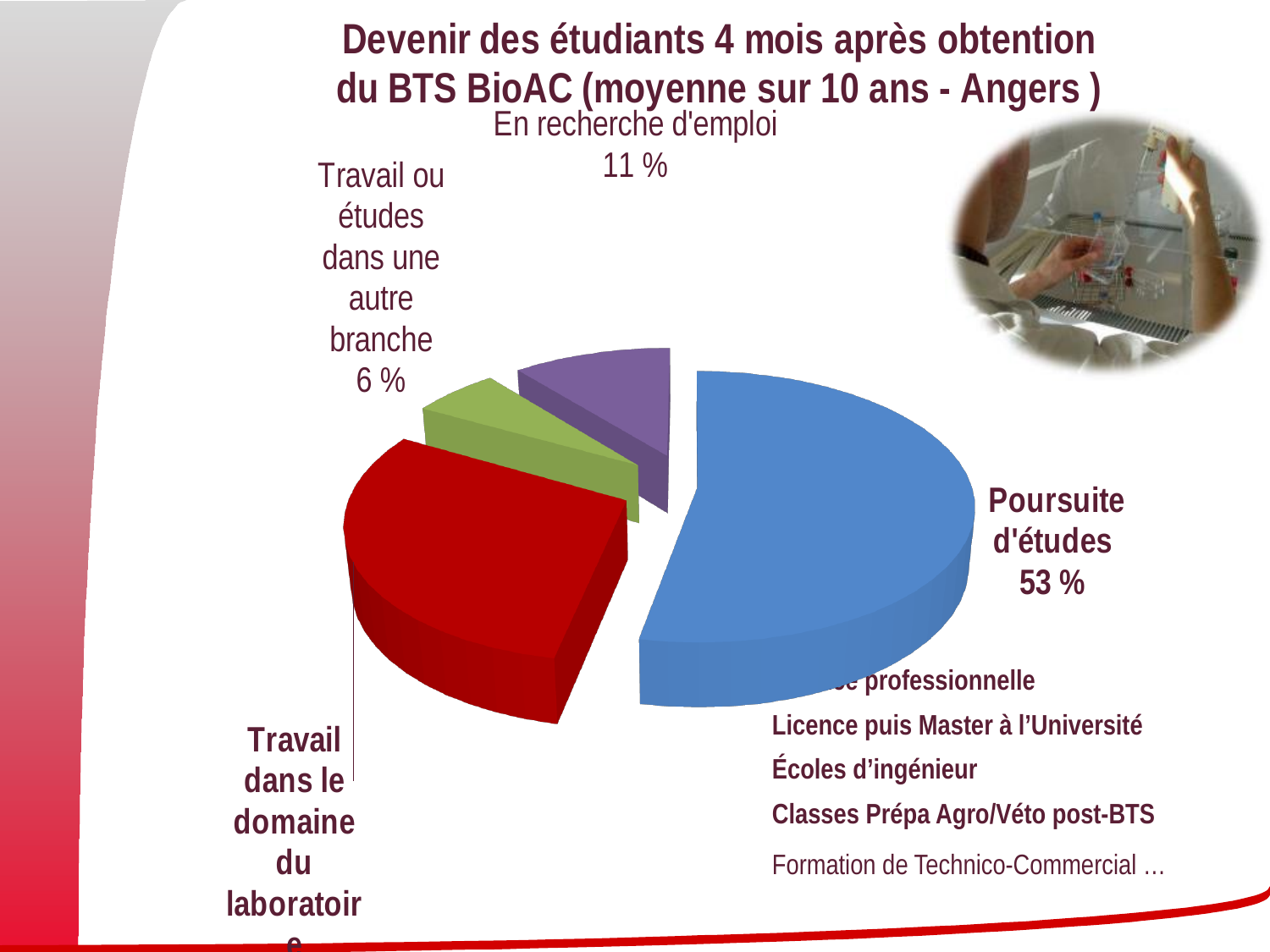
What percentage of students are in 'Poursuite d'études' 4 months after obtaining the BTS BioAC? 53 % Which category has the largest share of the pie? Poursuite d'études What colour is the 'Poursuite d'études' slice? Blue How many slices does the pie chart have? 4 Which is larger: the slice for 'Travail dans le domaine du laboratoire' or the slice for 'En recherche d'emploi'? Travail dans le domaine du laboratoire What percentage of students are 'En recherche d'emploi'? 11 % What is the difference in percentage points between 'Poursuite d'études' and 'En recherche d'emploi'? 42 % What percentage of students are in 'Travail ou études dans une autre branche'? 6 % Which is larger: the share for 'En recherche d'emploi' or for 'Travail ou études dans une autre branche'? En recherche d'emploi Which category has the smallest share of the pie? Travail ou études dans une autre branche Which is larger: the slice for 'Poursuite d'études' or the slice for 'Travail dans le domaine du laboratoire'? Poursuite d'études What type of chart is shown on the slide? Pie chart